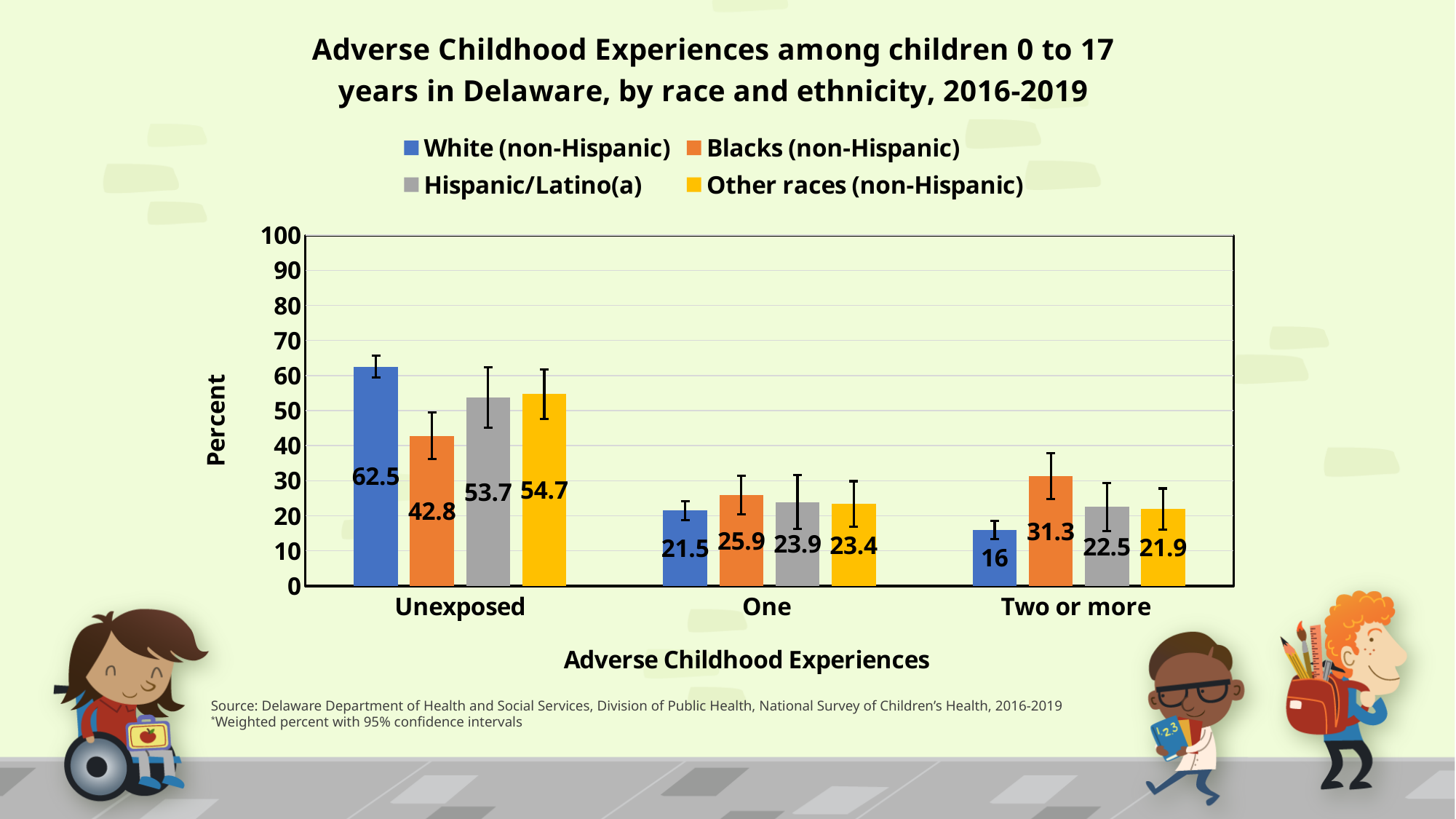
What is the label of the y axis? Percent What is the value for White (non-Hispanic) children in the Unexposed category? 62.5 How many series does the legend list? 4 What is the value for Hispanic/Latino(a) children in the One category? 23.9 What is the value for Other races (non-Hispanic) children in the Unexposed category? 54.7 Which race/ethnicity group has the highest value in the Unexposed category? White (non-Hispanic) What kind of chart is shown on the slide? Bar chart Which is larger in the One category: the value for Blacks (non-Hispanic) or the value for White (non-Hispanic)? Blacks (non-Hispanic) How many categories are shown on the x axis? 3 What is the value for Blacks (non-Hispanic) children in the Two or more category? 31.3 Which race/ethnicity group has the lowest value in the Two or more category? White (non-Hispanic) What is the difference between the White (non-Hispanic) and Blacks (non-Hispanic) values in the Unexposed category? 19.7